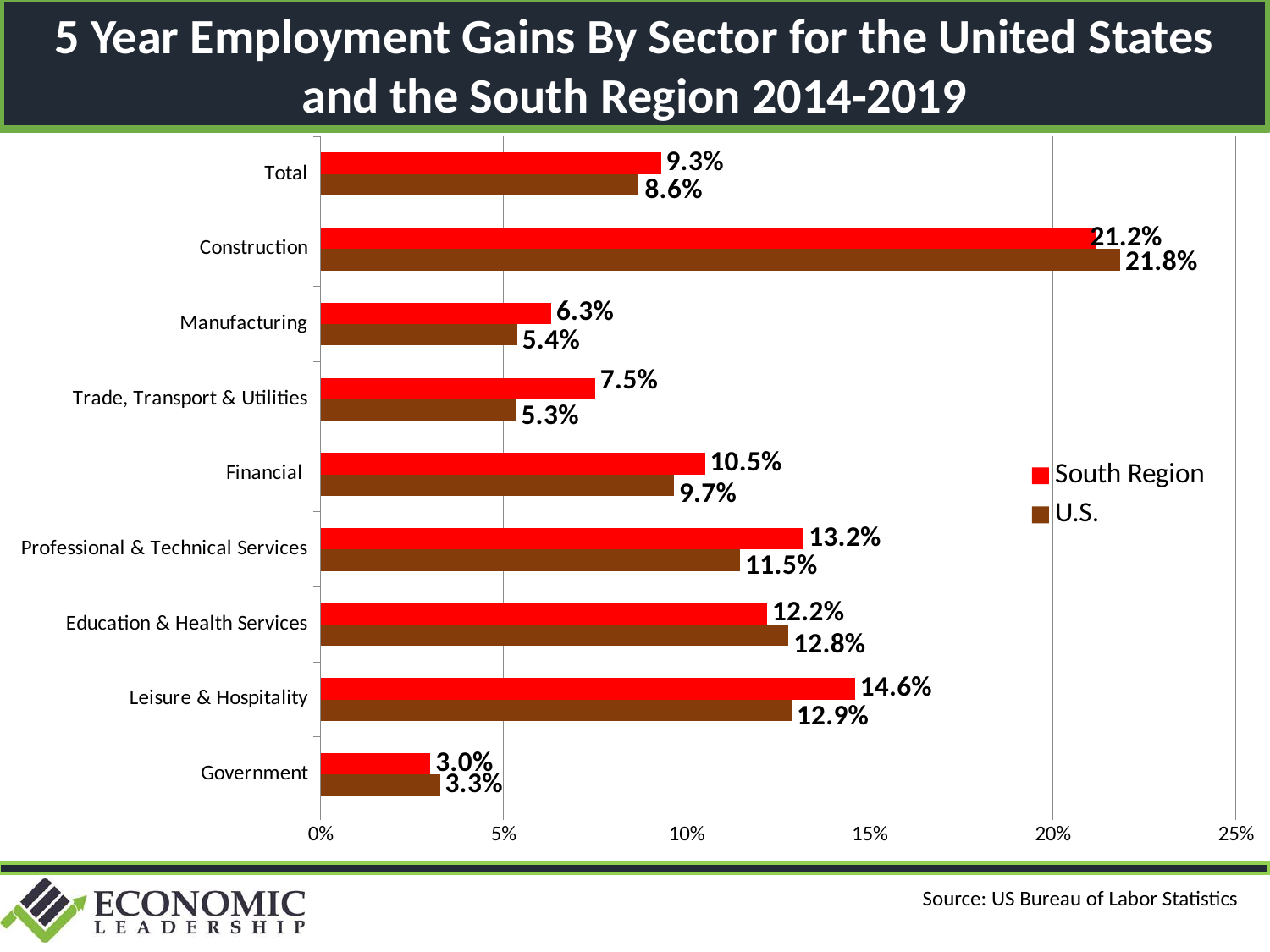
What is the difference between the South Region and U.S. values for Professional & Technical Services? 1.7% What is the U.S. value for Leisure & Hospitality? 12.9% Is the South Region value for Financial greater or less than 10%? greater Which is larger for Education & Health Services, the South Region value or the U.S. value? U.S. How many categories are shown on the y axis? 9 What colour represents the South Region series? Red Which category has the highest U.S. value? Construction What is the South Region value for Trade, Transport & Utilities? 7.5% What kind of chart is shown on the slide? Bar chart What is the South Region value for Construction? 21.2% Which category has the lowest South Region value? Government How many series does the legend list? 2